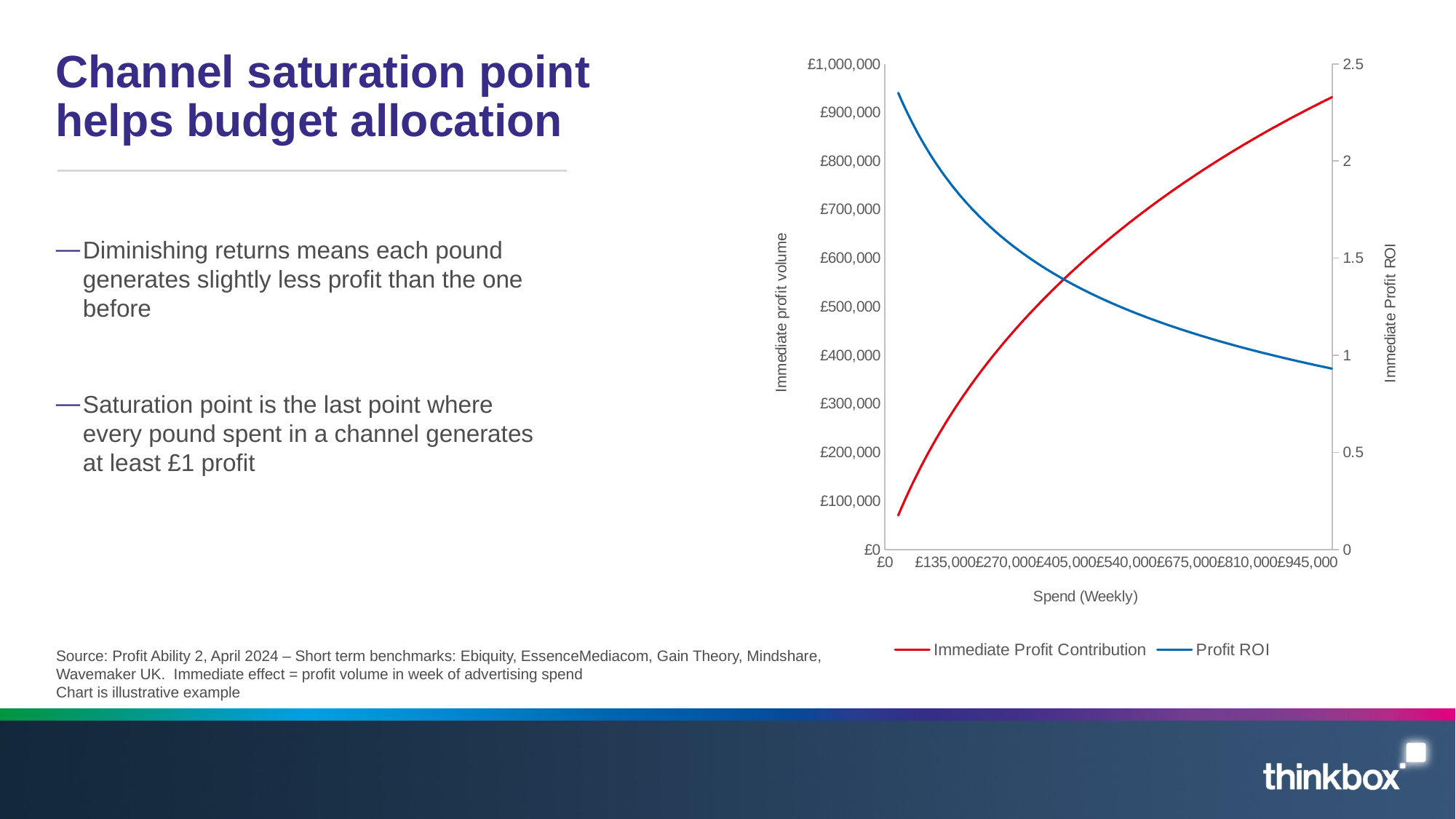
Which series is drawn in red on the chart? Immediate Profit Contribution Is the Profit ROI value at the highest spend shown greater or less than 1? less Does the Profit ROI line rise or fall as weekly spend increases? fall Does the Immediate Profit Contribution line rise or fall as weekly spend increases? rise Is the Immediate Profit Contribution at a weekly spend of £540,000 greater or less than £500,000? greater Is the Profit ROI at a weekly spend of £540,000 greater or less than 1.5? less How many series does the chart legend list? 2 What kind of chart is shown on the slide? line chart What is the title of the x axis of the chart? Spend (Weekly)